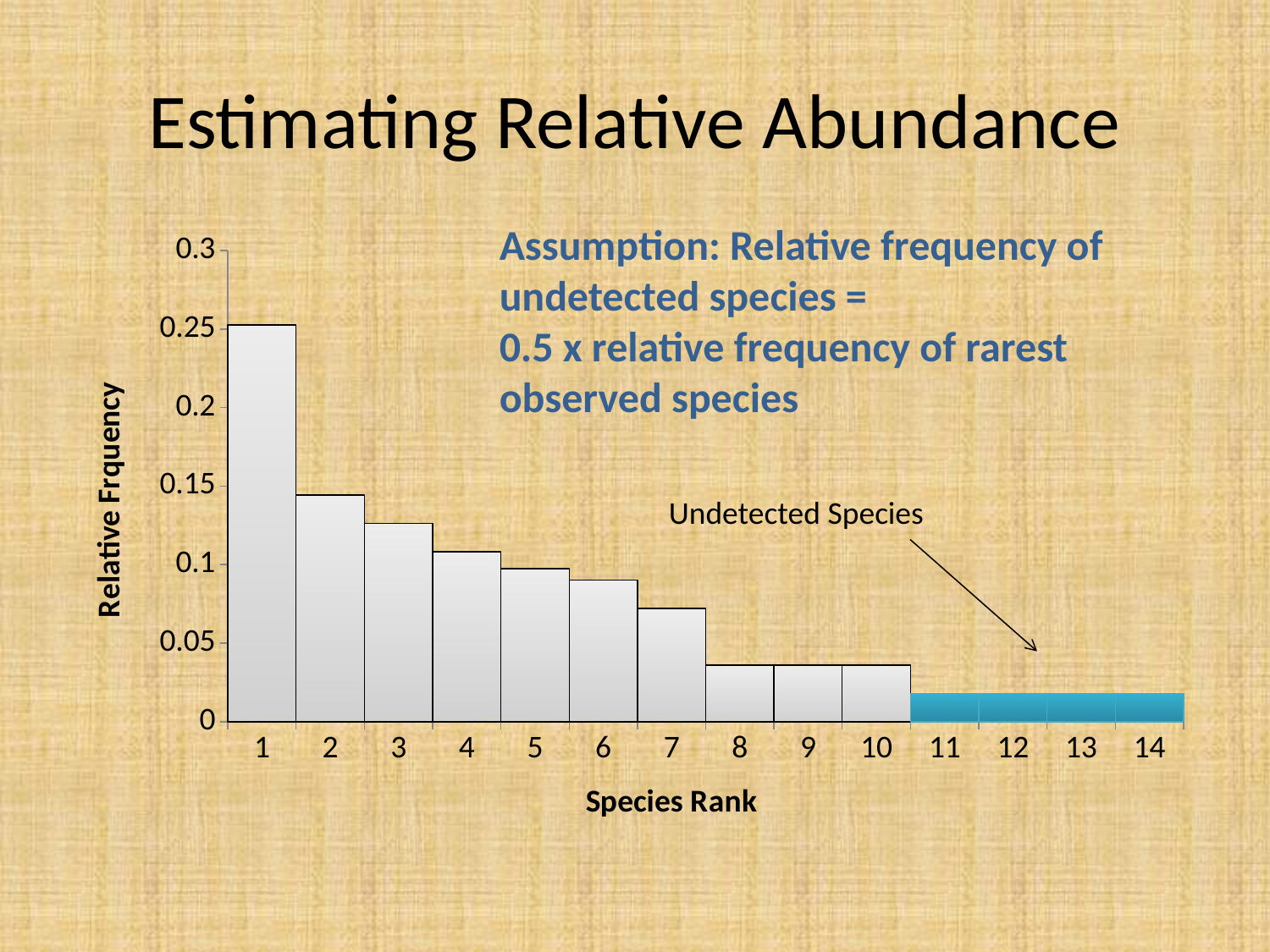
What is the title of the x axis of the chart? Species Rank How many species ranks are shown on the x axis? 14 Is the relative frequency for species rank 1 greater or less than 0.2? greater Which species rank has the highest relative frequency? 1 How many species ranks are shown as undetected species (blue bars)? 4 Do the relative frequencies rise or fall as species rank increases? fall Is the relative frequency for species rank 11 greater or less than 0.05? less What kind of chart is shown on the slide? bar chart Is the relative frequency for species rank 7 greater or less than 0.05? greater Which has the larger relative frequency, species rank 2 or species rank 6? species rank 2